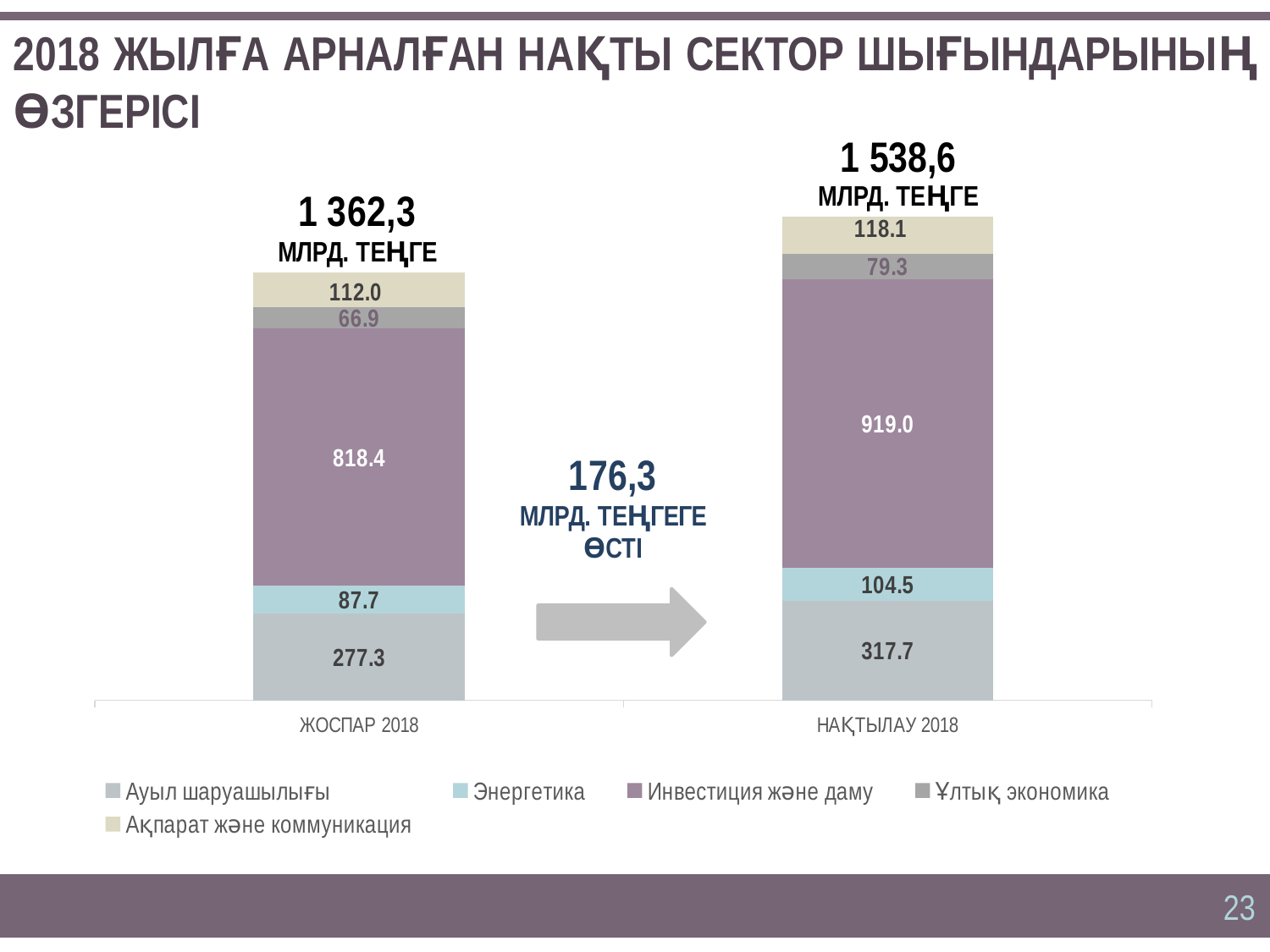
What is the difference between the Инвестиция және даму values for НАҚТЫЛАУ 2018 and ЖОСПАР 2018? 100.6 What is the total of the stacked bar for ЖОСПАР 2018? 1 362,3 млрд. теңге What is the value for Энергетика in ЖОСПАР 2018? 87.7 Which series has the smallest value in the НАҚТЫЛАУ 2018 bar? Ұлтық экономика What is the value for Инвестиция және даму in ЖОСПАР 2018? 818.4 Which is larger: Ұлтық экономика in ЖОСПАР 2018 or Ұлтық экономика in НАҚТЫЛАУ 2018? НАҚТЫЛАУ 2018 Which series has the largest value in the ЖОСПАР 2018 bar? Инвестиция және даму How many series does the legend list? 5 What is the total of the stacked bar for НАҚТЫЛАУ 2018? 1 538,6 млрд. теңге What is the value for Ақпарат және коммуникация in НАҚТЫЛАУ 2018? 118.1 What is the value for Ауыл шаруашылығы in НАҚТЫЛАУ 2018? 317.7 What kind of chart is shown on the slide? Stacked bar chart